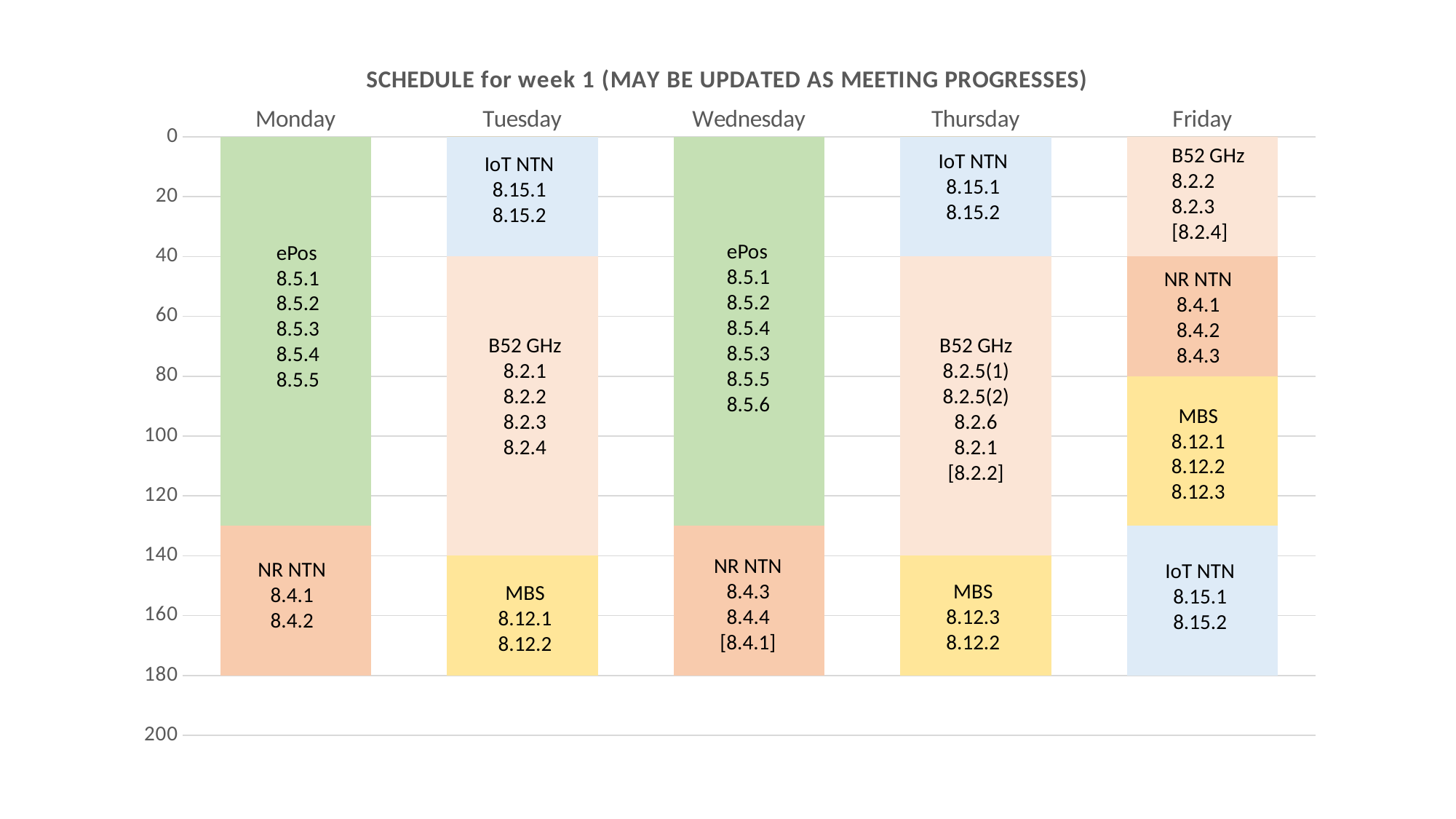
On which days does an ePos segment appear? Monday and Wednesday At what axis value does the IoT NTN segment of the Tuesday bar end? 40 What is the title of the chart? SCHEDULE for week 1 (MAY BE UPDATED AS MEETING PROGRESSES) How many days (categories) are shown along the x axis? 5 Is the length of the MBS segment in the Friday bar greater or less than 40? greater How many segments does the Friday bar contain? 4 Between which two axis values does the B52 GHz segment of the Thursday bar span? 40 and 140 In the Monday bar, which segment is larger: ePos or NR NTN? ePos What kind of chart is shown on the slide? Stacked bar chart Is the length of the ePos segment in the Monday bar greater or less than 120? greater Which day's bar has the most segments? Friday At what axis value does the bottom of the Monday bar end? 180